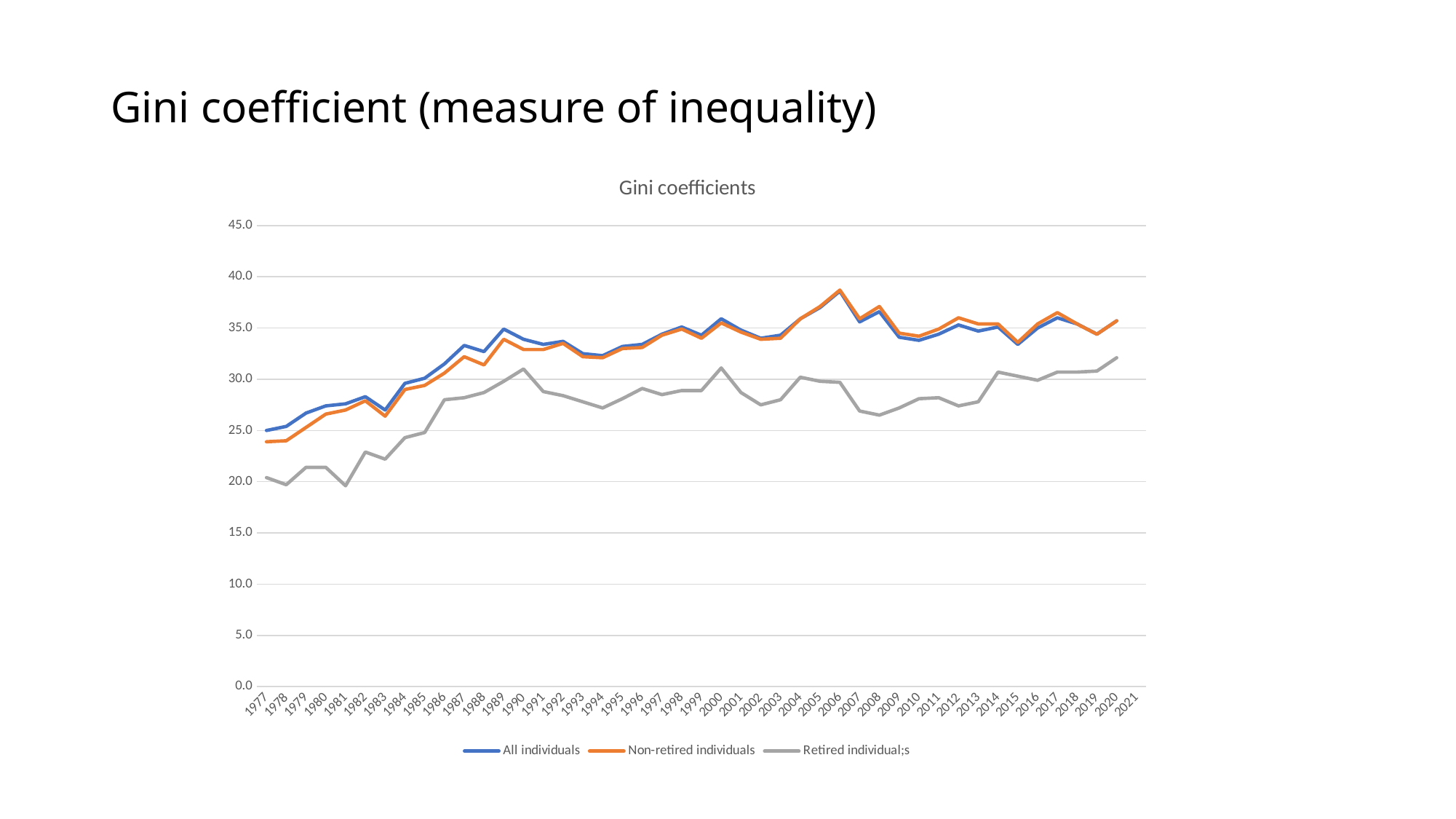
How many series does the legend list? 3 Is the value for Retired individual;s in 1977 greater or less than 25.0? less In which year is the All individuals series at its lowest value? 1977 What is the title of the chart? Gini coefficients Is the value for Retired individual;s in 2020 greater or less than 30.0? greater Does the All individuals series generally rise or fall between 1977 and 1990? rise What kind of chart is shown on the slide? line chart Which series is drawn in grey? Retired individual;s Is the value for All individuals in 1977 greater or less than 30.0? less In which year does the Non-retired individuals series reach its highest value? 2006 In 2000, which series has the higher value: All individuals or Retired individual;s? All individuals